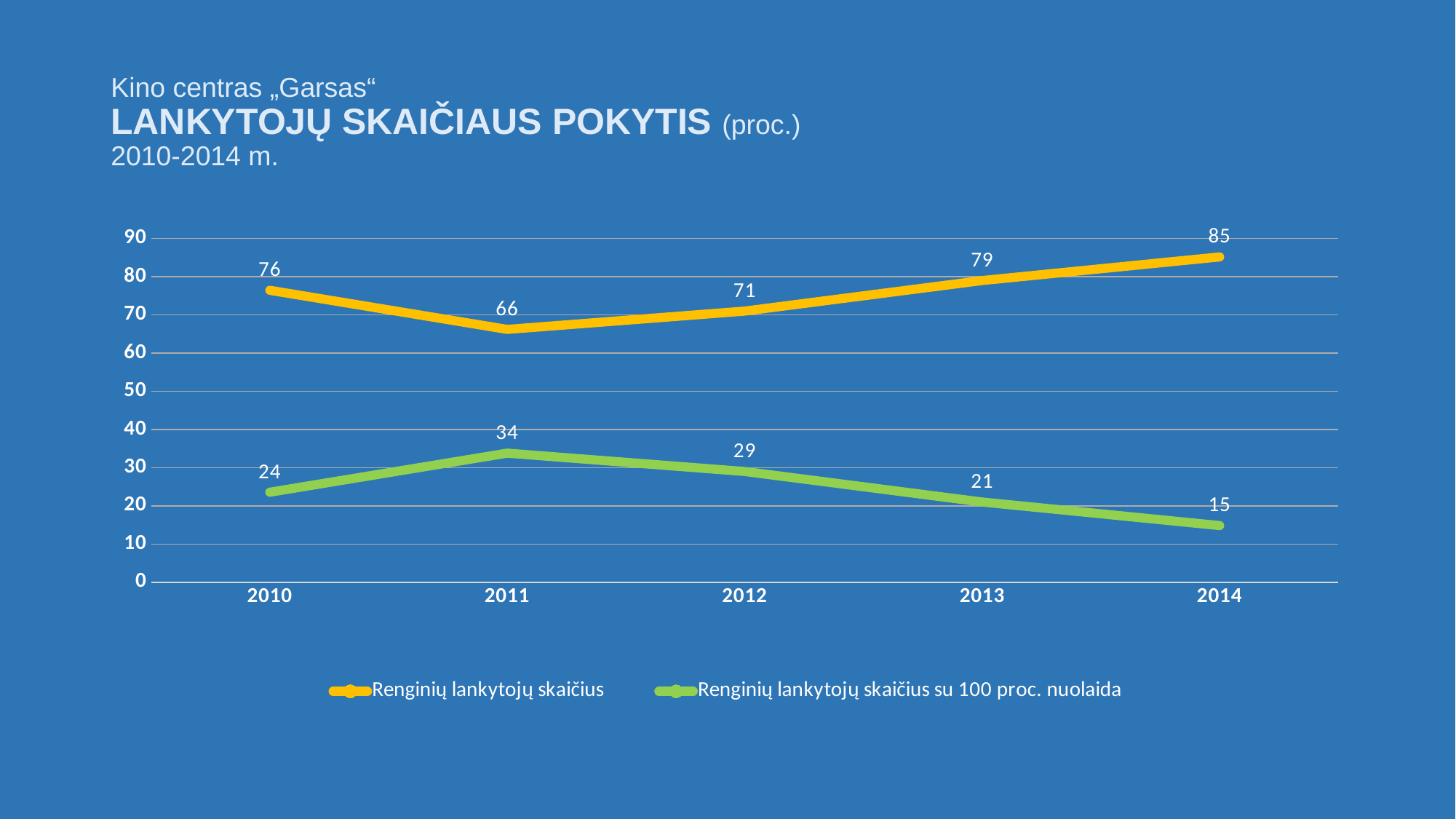
What is the value for "Renginių lankytojų skaičius su 100 proc. nuolaida" in 2011? 34 In which year is "Renginių lankytojų skaičius" highest? 2014 In which year is "Renginių lankytojų skaičius su 100 proc. nuolaida" lowest? 2014 What is the value for "Renginių lankytojų skaičius" in 2012? 71 Does "Renginių lankytojų skaičius su 100 proc. nuolaida" rise or fall from 2011 to 2014? fall What type of chart is shown on the slide? line chart What is the difference between the two series in 2010? 52 How many series does the legend list? 2 What colour is the line for "Renginių lankytojų skaičius su 100 proc. nuolaida"? green Which is larger: "Renginių lankytojų skaičius" in 2011 or in 2013? 2013 What is the value for "Renginių lankytojų skaičius" in 2011? 66 How many years are shown on the x axis? 5